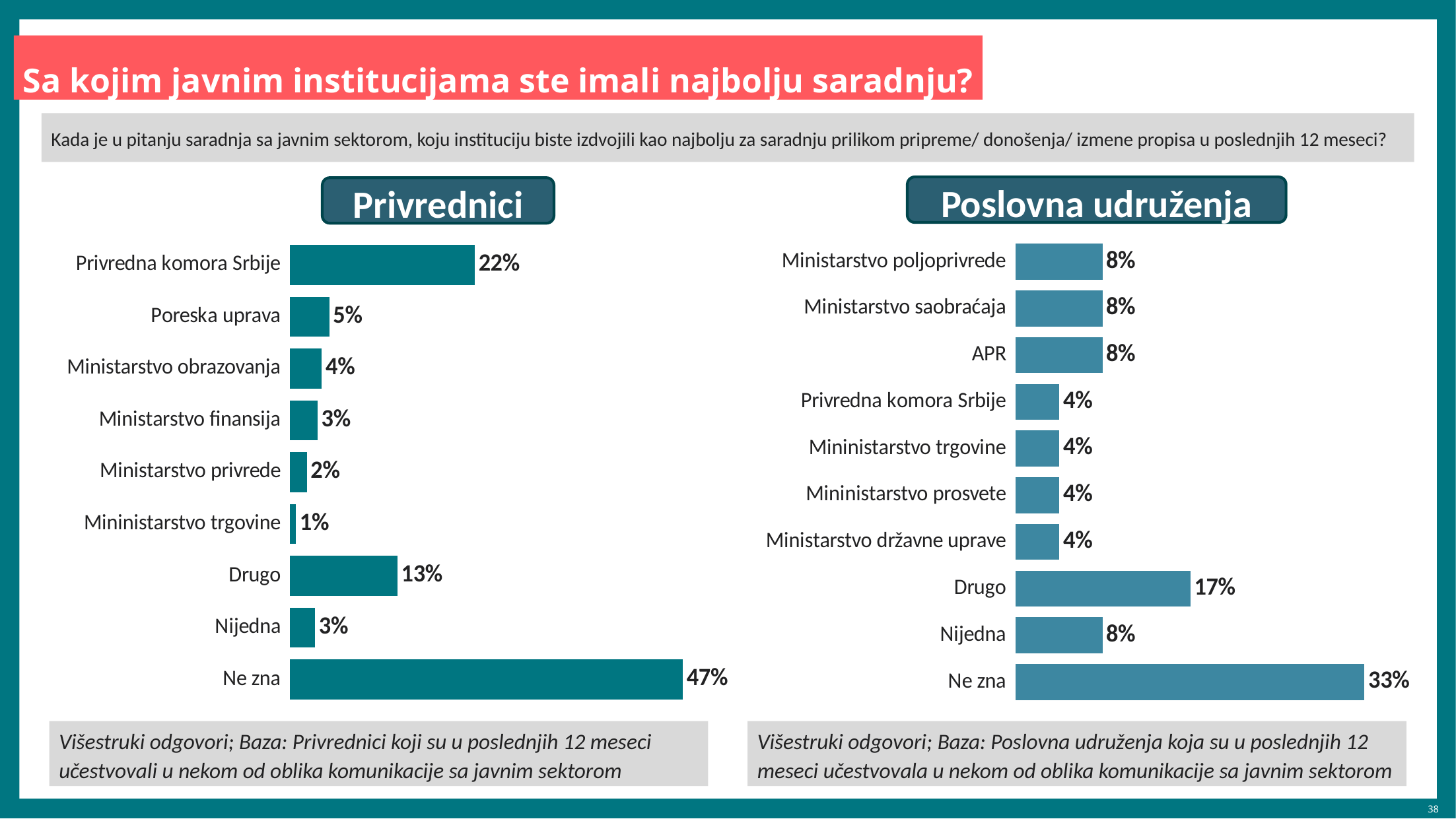
In the Poslovna udruženja chart, what is the value for Drugo? 17% What type of chart is the Poslovna udruženja chart? Bar chart Which is larger: Privredna komora Srbije in the Privrednici chart or Privredna komora Srbije in the Poslovna udruženja chart? Privrednici In the Privrednici chart, what is the value for Privredna komora Srbije? 22% In the Privrednici chart, which category has the lowest value? Mininistarstvo trgovine How many categories are shown in the Poslovna udruženja chart? 10 How many categories are shown in the Privrednici chart? 9 In the Privrednici chart, what is the difference between Ne zna and Privredna komora Srbije? 25% In the Privrednici chart, which is larger: Poreska uprava or Drugo? Drugo In the Privrednici chart, which category has the highest value? Ne zna In the Poslovna udruženja chart, which category has the highest value? Ne zna In the Poslovna udruženja chart, what is the difference between Ne zna and Drugo? 16%